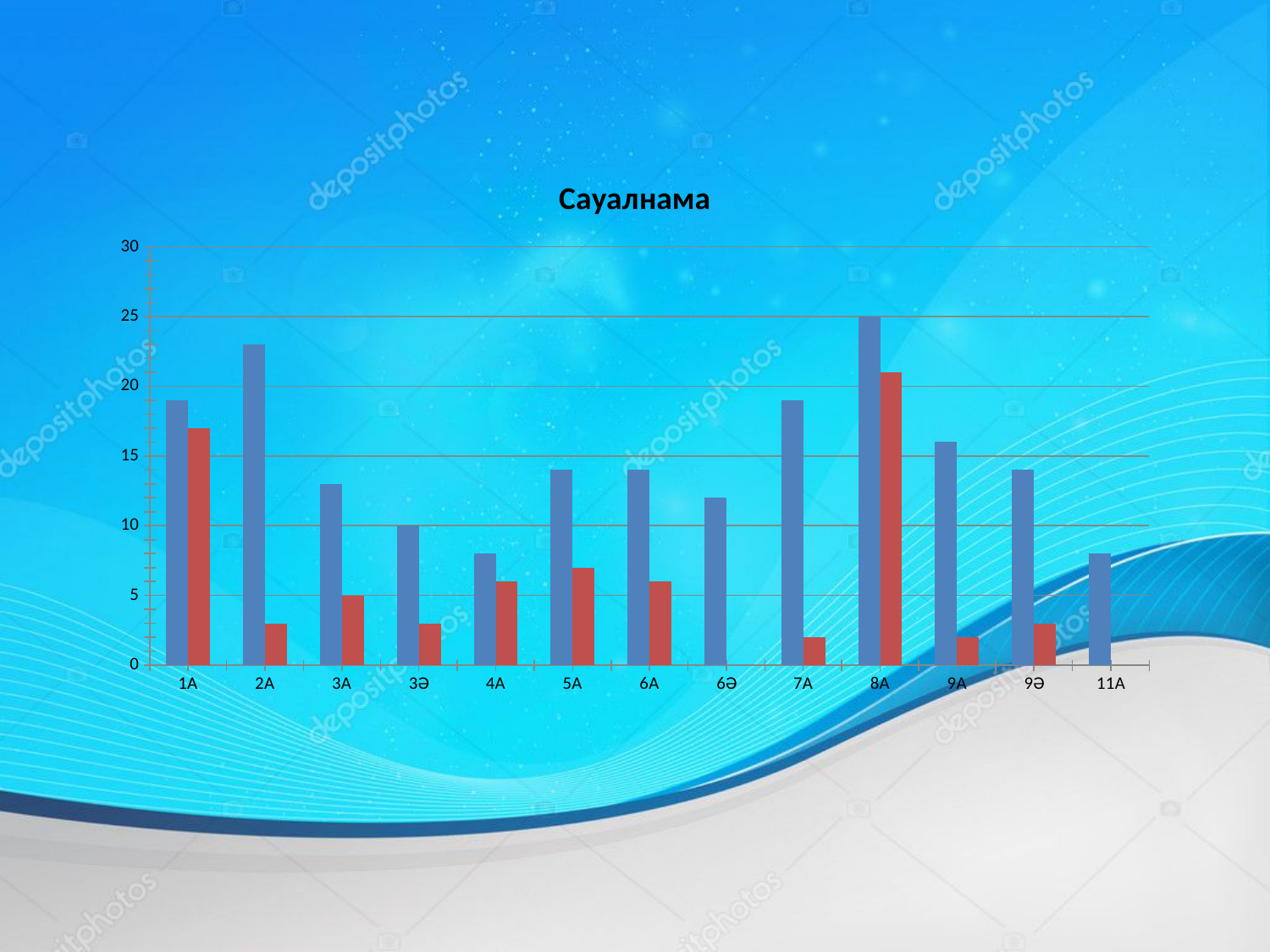
Is the value of the blue bar for 6Ә greater or less than 10? greater What kind of chart is shown on the slide? bar chart Is the value of the red bar for 7А greater or less than 5? less How many categories are shown on the x axis of the chart? 13 What is the title of the chart? Сауалнама Is the value of the blue bar for 2А greater or less than 20? greater Which category has the tallest blue bar? 8А What two colours are used for the bars in the chart? blue and red What is the value of the blue bar for 8А? 25 Which is larger, the red bar for 1А or the red bar for 2А? 1А Which category has the tallest red bar? 8А Which is larger, the blue bar for 2А or the blue bar for 3А? 2А